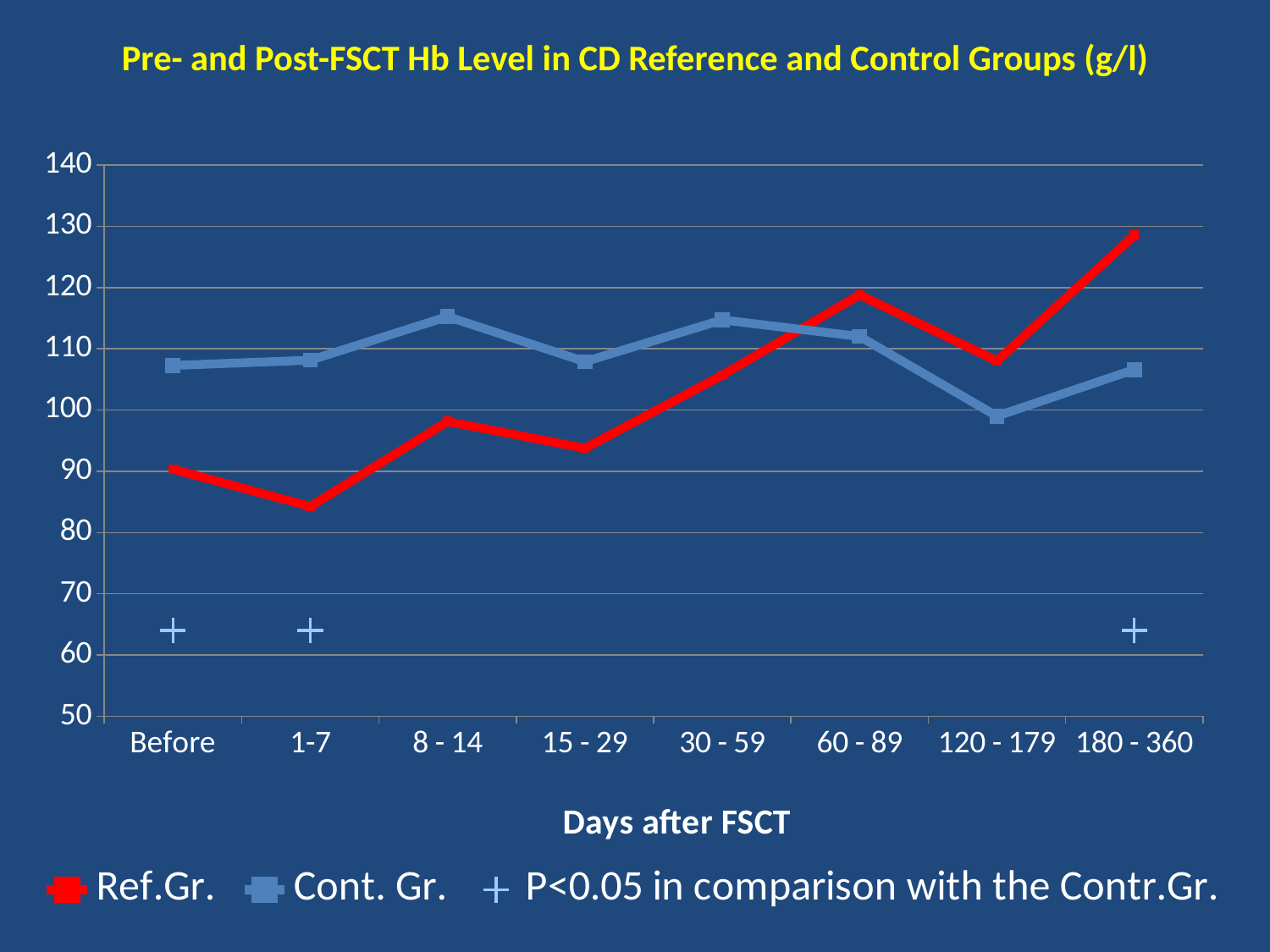
How many time-point categories are shown on the x axis? 8 What kind of chart is shown on the slide? Line chart At which time point is the Ref.Gr. Hb level lowest? 1-7 How many entries does the legend list? 3 At 180 - 360 days, which group has the higher Hb level, Ref.Gr. or Cont. Gr.? Ref.Gr. Is the Ref.Gr. value at 180 - 360 greater or less than 120? greater Is the Cont. Gr. value at 8 - 14 greater or less than 110? greater At the Before time point, which group has the higher Hb level, Ref.Gr. or Cont. Gr.? Cont. Gr. What is the label of the x axis? Days after FSCT At which time point is the Ref.Gr. Hb level highest? 180 - 360 At which time point is the Cont. Gr. Hb level lowest? 120 - 179 Is the Ref.Gr. value at 1-7 greater or less than 90? less